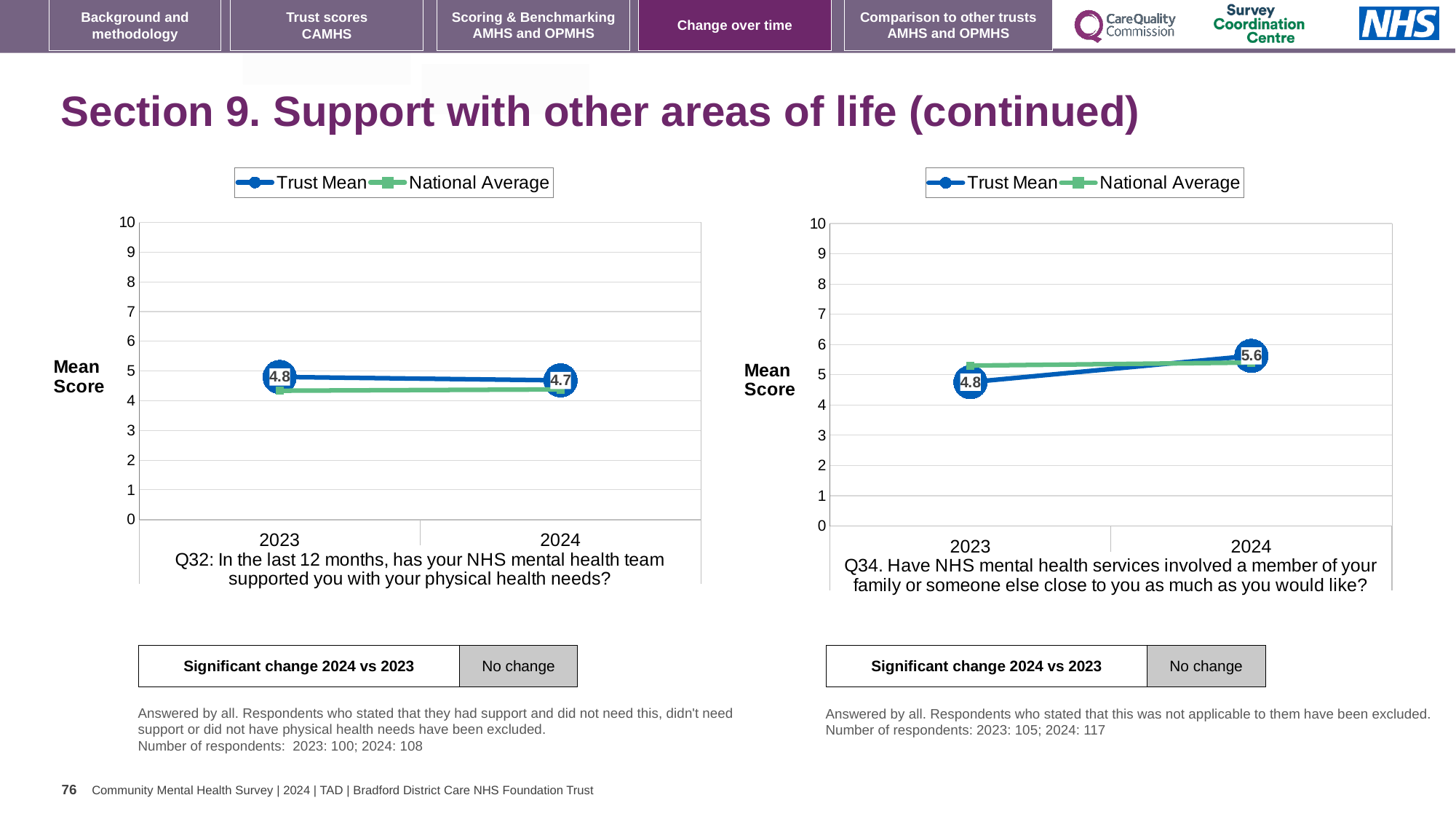
In the Q32 chart on the left, which is larger in 2023, the Trust Mean or the National Average? Trust Mean What kind of chart is the Q32 chart on the left? line chart In the Q34 chart on the right, what is the Trust Mean for 2023? 4.8 In the Q32 chart on the left, what is the difference between the Trust Mean for 2023 and 2024? 0.1 How many series does the legend of the Q34 chart on the right list? 2 In the Q34 chart on the right, by how much did the Trust Mean change from 2023 to 2024? 0.8 In the Q32 chart on the left, what is the Trust Mean for 2024? 4.7 In the Q32 chart on the left, what is the Trust Mean for 2023? 4.8 In the Q34 chart on the right, what is the Trust Mean for 2024? 5.6 In the Q34 chart on the right, is the National Average for 2023 greater or less than 5? greater In the Q32 chart on the left, is the National Average for 2023 greater or less than 5? less In the Q34 chart on the right, does the Trust Mean rise or fall from 2023 to 2024? rise